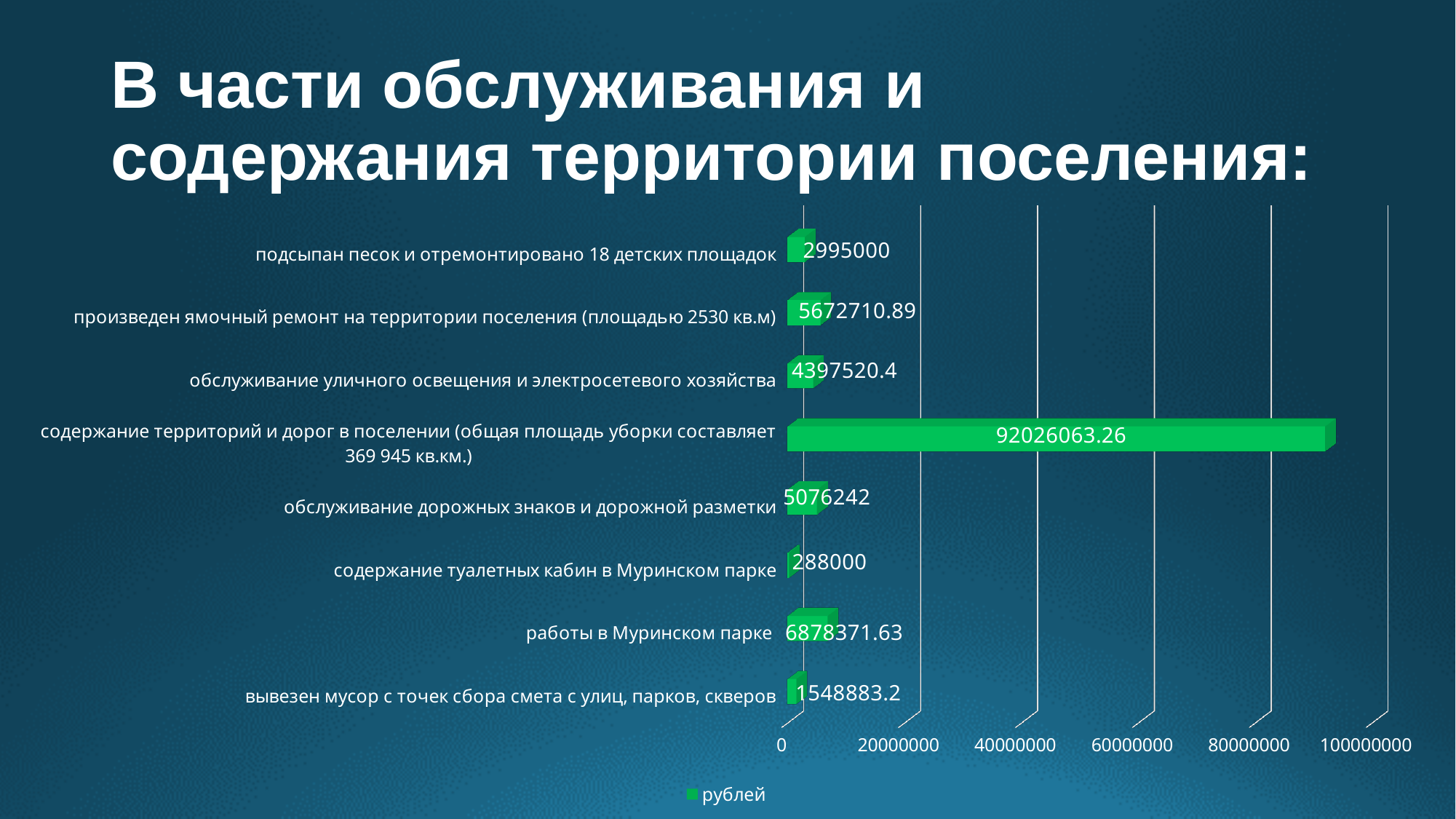
What is the value for "вывезен мусор с точек сбора смета с улиц, парков, скверов"? 1548883.2 Which category has the lowest value? содержание туалетных кабин в Муринском парке What is the value for "подсыпан песок и отремонтировано 18 детских площадок"? 2995000 What type of chart is shown on the slide? bar chart Is the value for "содержание территорий и дорог в поселении (общая площадь уборки составляет 369 945 кв.км.)" greater or less than 80000000? greater What is the difference between the values for "подсыпан песок и отремонтировано 18 детских площадок" and "содержание туалетных кабин в Муринском парке"? 2707000 How many series does the legend list? 1 What is the value for "работы в Муринском парке"? 6878371.63 Which is larger: the value for "произведен ямочный ремонт на территории поселения (площадью 2530 кв.м)" or for "обслуживание уличного освещения и электросетевого хозяйства"? произведен ямочный ремонт на территории поселения (площадью 2530 кв.м) What is the name of the series shown in the legend? рублей Which category has the highest value? содержание территорий и дорог в поселении (общая площадь уборки составляет 369 945 кв.км.) How many categories are plotted in the chart? 8